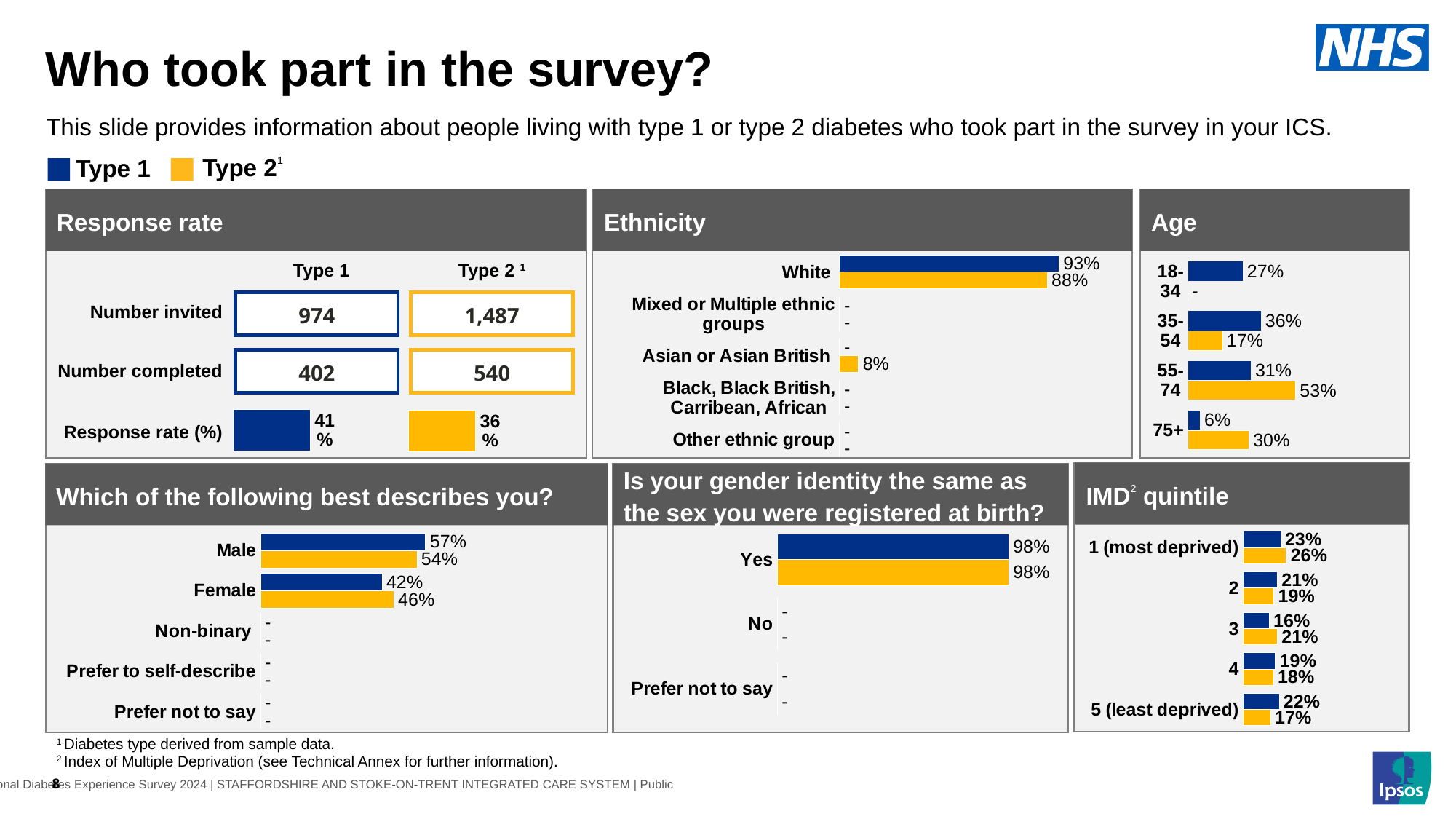
In the 'Which of the following best describes you?' chart, is the Type 1 value for Male larger or smaller than the Type 2 value for Male? larger In the Ethnicity chart, what is the Type 2 value for Asian or Asian British? 8% In the Ethnicity chart, what percentage of Type 1 respondents are White? 93% In the IMD quintile chart, what is the Type 2 value for quintile 1 (most deprived)? 26% In the Response rate panel, how many Type 2 people were invited? 1,487 In the Age chart, which age group has the lowest Type 1 value? 75+ In the IMD quintile chart, which quintile has the lowest Type 1 value? 3 In the Age chart, which age group has the highest Type 2 value? 55-74 In the Age chart, what is the difference between the Type 2 and Type 1 values for the 75+ group? 24 percentage points In the 'Which of the following best describes you?' chart, what is the Type 2 value for Female? 46% In the gender identity chart, what percentage of Type 1 respondents answered Yes? 98% How many series does the legend at the top of the slide list? 2